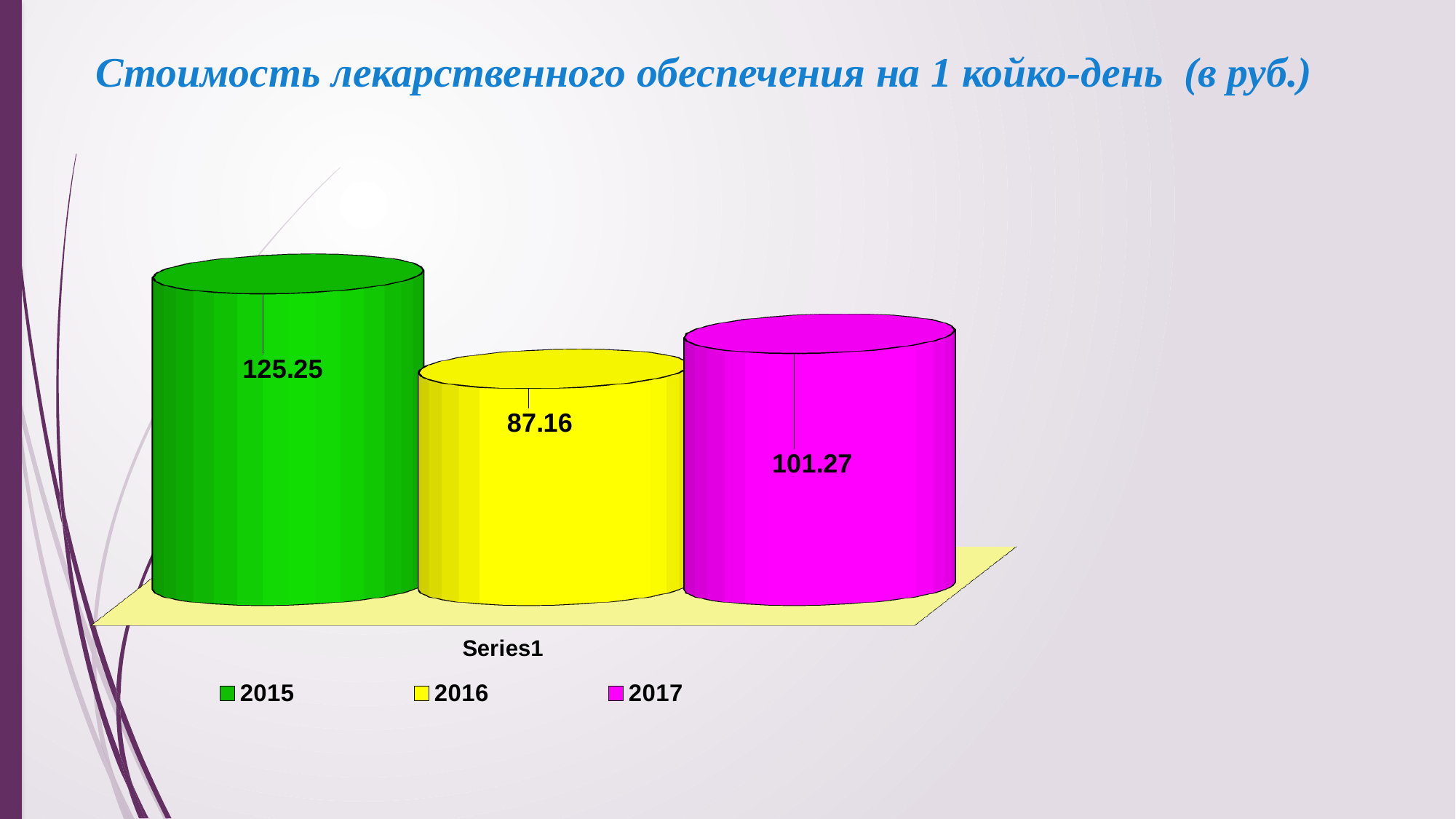
Which is larger, the value for 2017 or the value for 2016? 2017 What kind of chart is shown on the slide? Bar chart What is the value for 2016? 87.16 What is the value for 2015? 125.25 Which year has the lowest value? 2016 What colour is the bar for 2017? Magenta What is the difference between the values for 2015 and 2016? 38.09 What is the title of the chart? Стоимость лекарственного обеспечения на 1 койко-день (в руб.) What is the value for 2017? 101.27 How many series does the legend list? 3 Which year has the highest value? 2015 What is the difference between the values for 2017 and 2016? 14.11